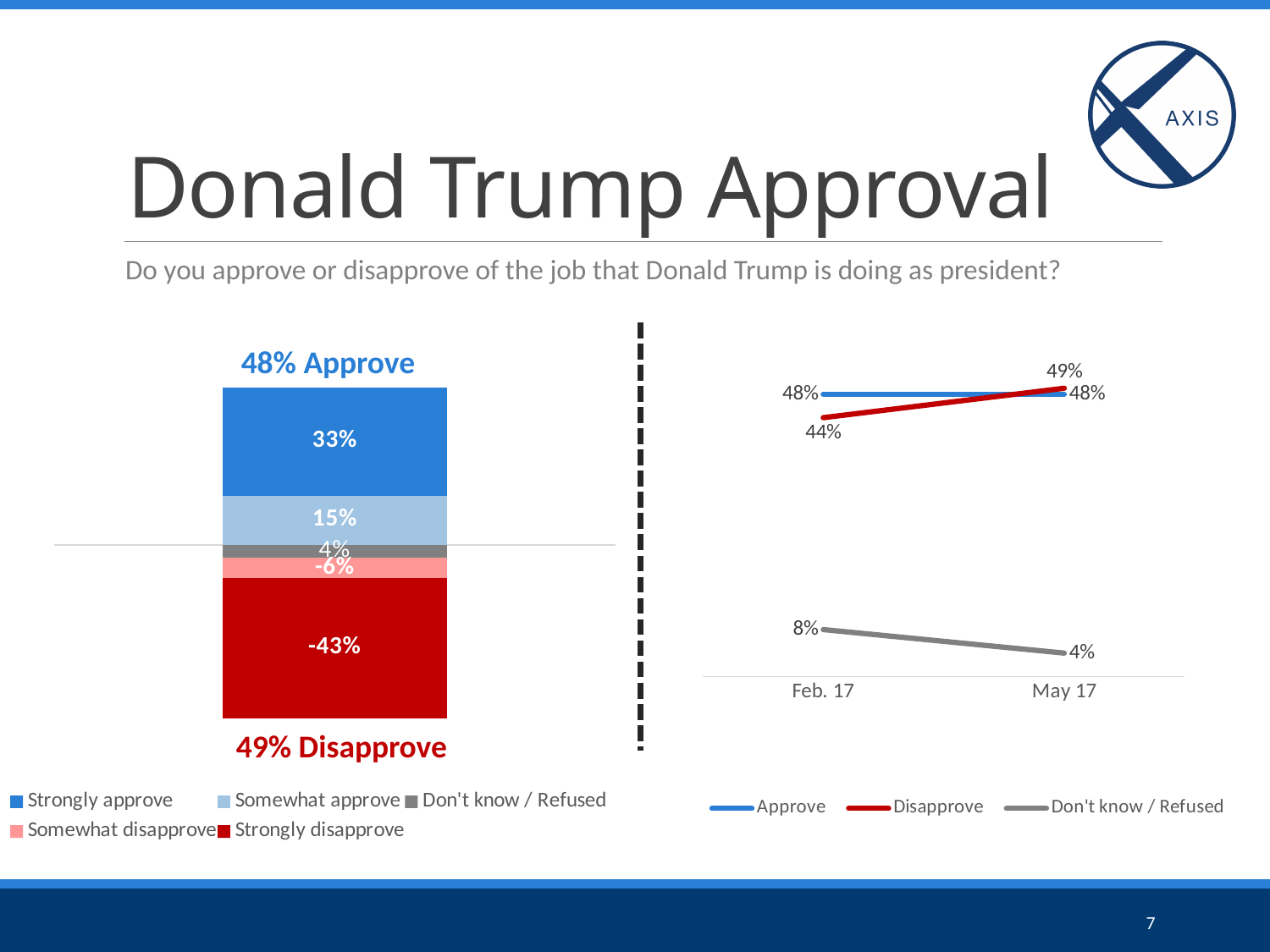
What kind of chart is shown on the right side of the slide? line chart In the stacked bar chart on the left, what is the value for Somewhat approve? 15% In the line chart on the right, what is the Disapprove value for Feb. 17? 44% In the line chart on the right, how many series does the legend list? 3 In the line chart on the right, what is the Disapprove value for May 17? 49% In the line chart on the right, how many time points are shown on the x axis? 2 In the line chart on the right, what is the Don't know / Refused value for May 17? 4% In the stacked bar chart on the left, what is the difference between the Strongly approve value and the Somewhat approve value? 18% In the stacked bar chart on the left, what is the value for Strongly disapprove? -43% In the stacked bar chart on the left, what is the value for Strongly approve? 33% In the stacked bar chart on the left, how many series does the legend list? 5 In the line chart on the right, does the Don't know / Refused series rise or fall from Feb. 17 to May 17? fall